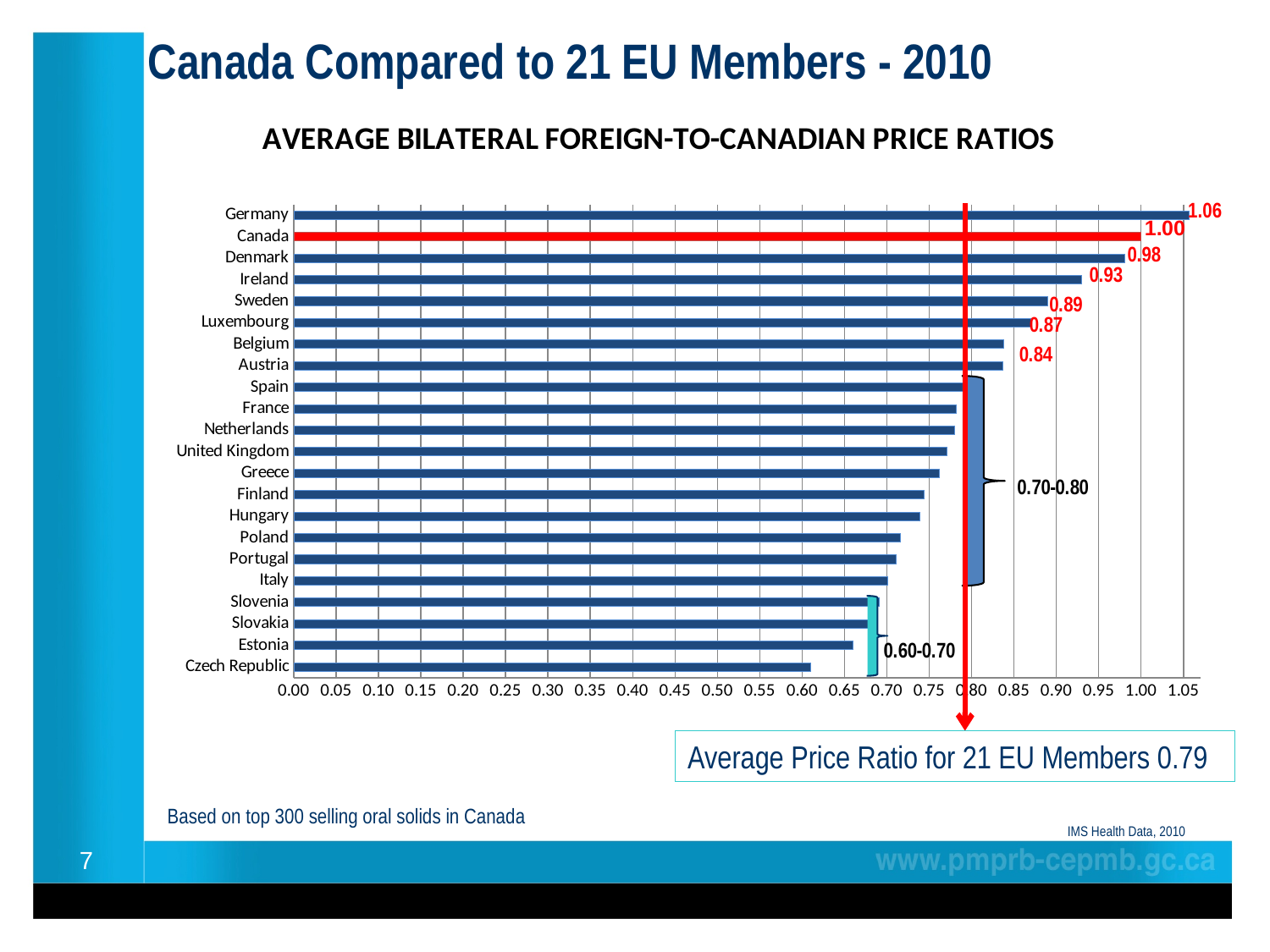
Which country has the highest price ratio in the chart? Germany What is the price ratio shown for Denmark? 0.98 Is the value for Hungary greater or less than 0.70? greater Which country has the lowest price ratio in the chart? Czech Republic Which has a larger price ratio, Sweden or Luxembourg? Sweden What is the difference between the price ratios of Denmark and Ireland? 0.05 What is the difference between the price ratios of Germany and Canada? 0.06 What is the average price ratio for the 21 EU members stated on the slide? 0.79 Is the value for Czech Republic greater or less than 0.65? less How many countries are listed in the chart? 22 What is the price ratio shown for Sweden? 0.89 What is the average bilateral foreign-to-Canadian price ratio for Germany? 1.06